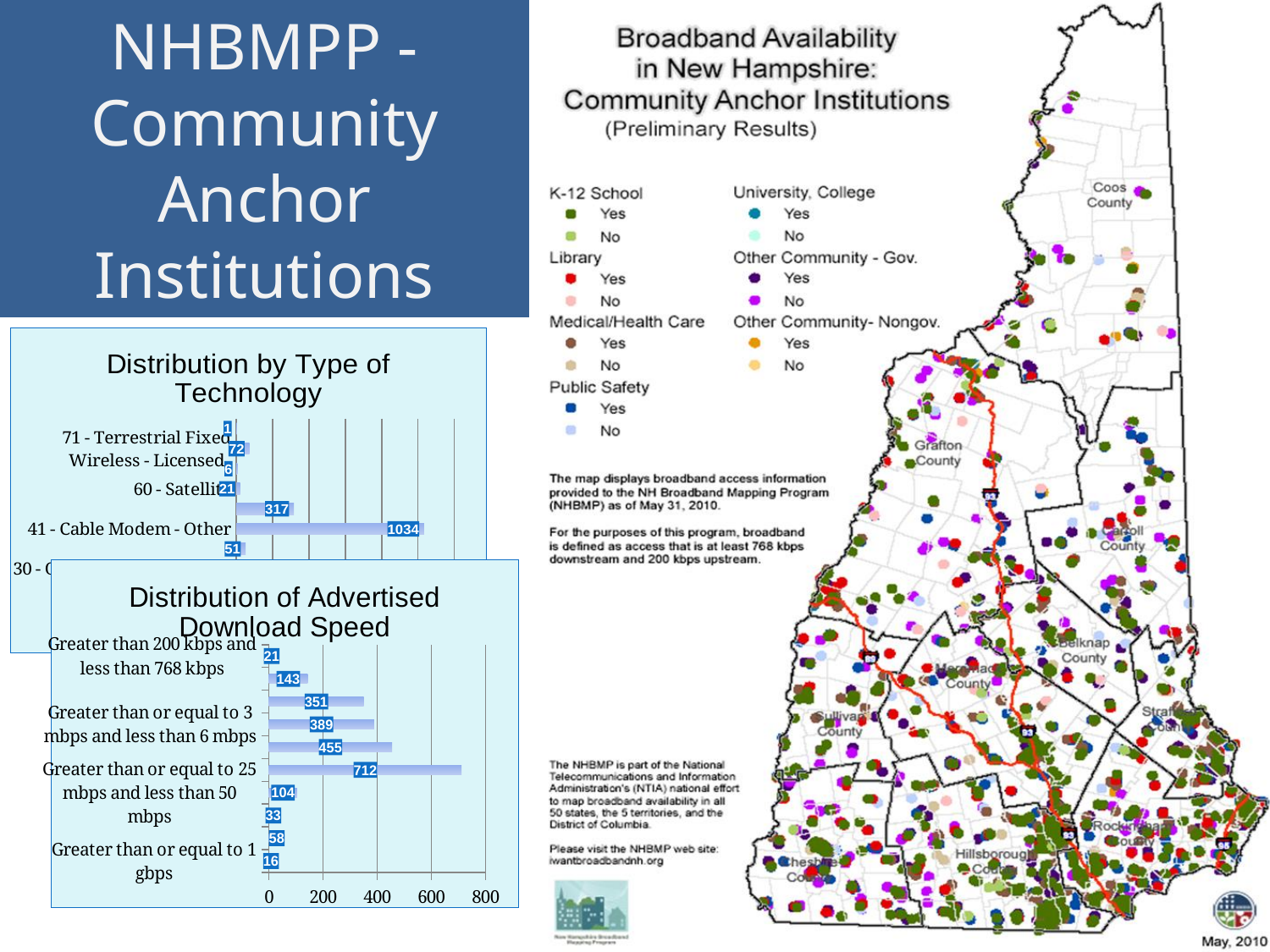
In the 'Distribution of Advertised Download Speed' chart, what kind of chart is shown? Bar chart In the 'Distribution of Advertised Download Speed' chart, what is the value for 'Greater than or equal to 25 mbps and less than 50 mbps'? 104 In the 'Distribution by Type of Technology' chart, what is the value for '41 - Cable Modem - Other'? 1034 In the 'Distribution of Advertised Download Speed' chart, what is the value for 'Greater than or equal to 3 mbps and less than 6 mbps'? 389 In the 'Distribution of Advertised Download Speed' chart, how many bars are plotted? 10 In the 'Distribution of Advertised Download Speed' chart, what is the lowest value shown? 16 In the 'Distribution of Advertised Download Speed' chart, what is the difference between the bar labelled 712 and the bar labelled 455? 257 In the 'Distribution of Advertised Download Speed' chart, is the largest bar greater or less than 600? greater In the 'Distribution of Advertised Download Speed' chart, what is the value for 'Greater than or equal to 1 gbps'? 16 In the 'Distribution of Advertised Download Speed' chart, what is the highest value shown? 712 In the 'Distribution by Type of Technology' chart, what is the difference between the bar labelled 1034 and the bar labelled 317? 717 In the 'Distribution by Type of Technology' chart, what is the value for '60 - Satellite'? 21